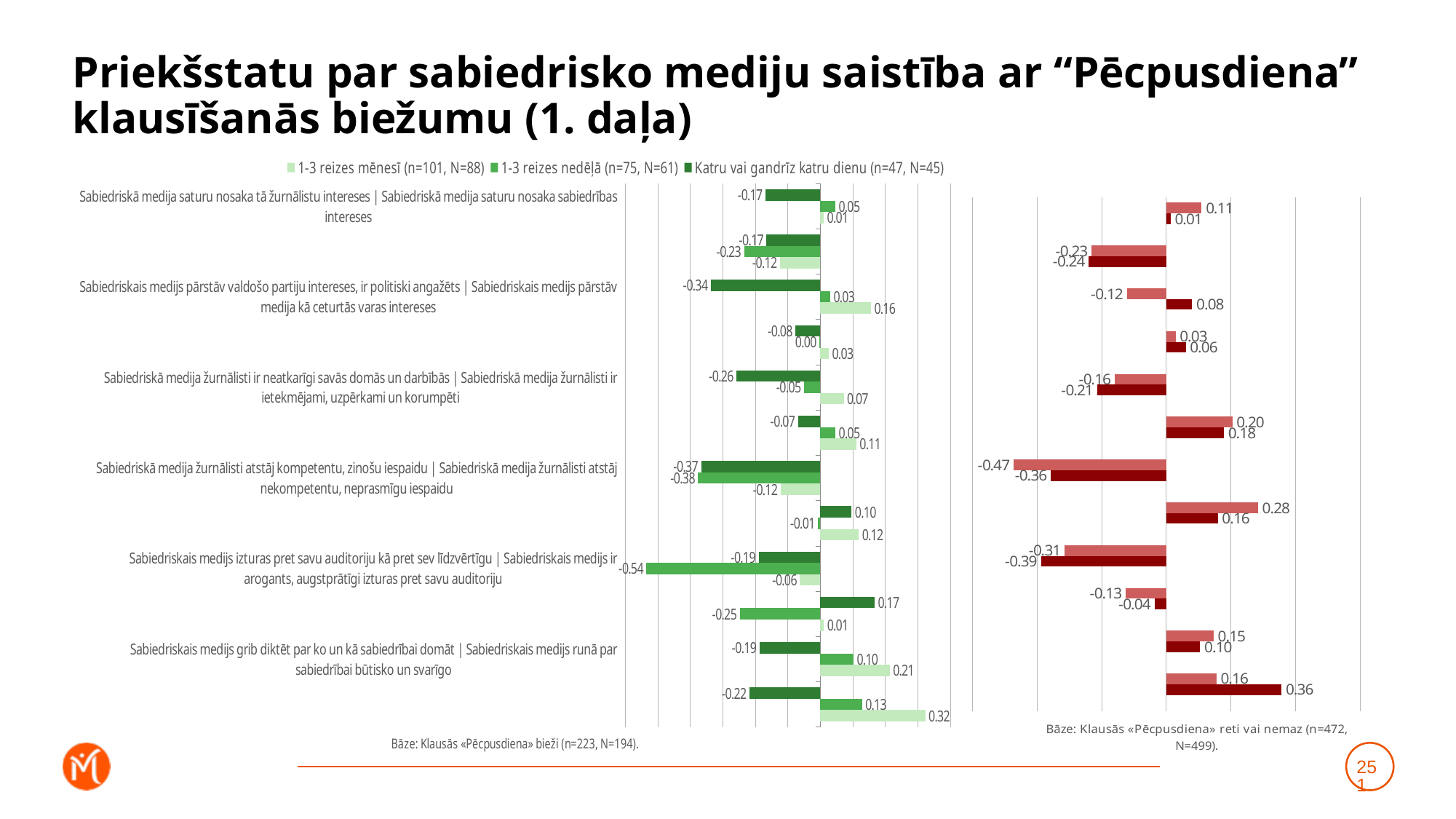
In the left (green) chart, how many series does the legend list? 3 What is the lowest value shown in the right (red) chart? -0.47 What is the highest value shown in the left (green) chart? 0.32 In the left (green) chart, for the statement 'Sabiedriskā medija žurnālisti ir neatkarīgi savās domās un darbībās', what is the difference between the '1-3 reizes mēnesī' value and the 'Katru vai gandrīz katru dienu' value? 0.33 According to the legend of the left (green) chart, what sample sizes are given for '1-3 reizes nedēļā'? n=75, N=61 What is the lowest value shown in the left (green) chart? -0.54 What kind of chart is used on this slide? Bar chart In the left (green) chart, what is the value for '1-3 reizes mēnesī' for the statement 'Sabiedriskais medijs grib diktēt par ko un kā sabiedrībai domāt'? 0.21 What is the highest value shown in the right (red) chart? 0.36 In the left (green) chart, what is the value for '1-3 reizes nedēļā' for the statement 'Sabiedriskā medija žurnālisti atstāj kompetentu, zinošu iespaidu'? -0.38 In the left (green) chart, for the statement 'Sabiedriskais medijs pārstāv valdošo partiju intereses, ir politiski angažēts', which series has the larger value: '1-3 reizes mēnesī' or '1-3 reizes nedēļā'? 1-3 reizes mēnesī In the left (green) chart, what is the value for 'Katru vai gandrīz katru dienu' for the statement 'Sabiedriskais medijs pārstāv valdošo partiju intereses, ir politiski angažēts'? -0.34